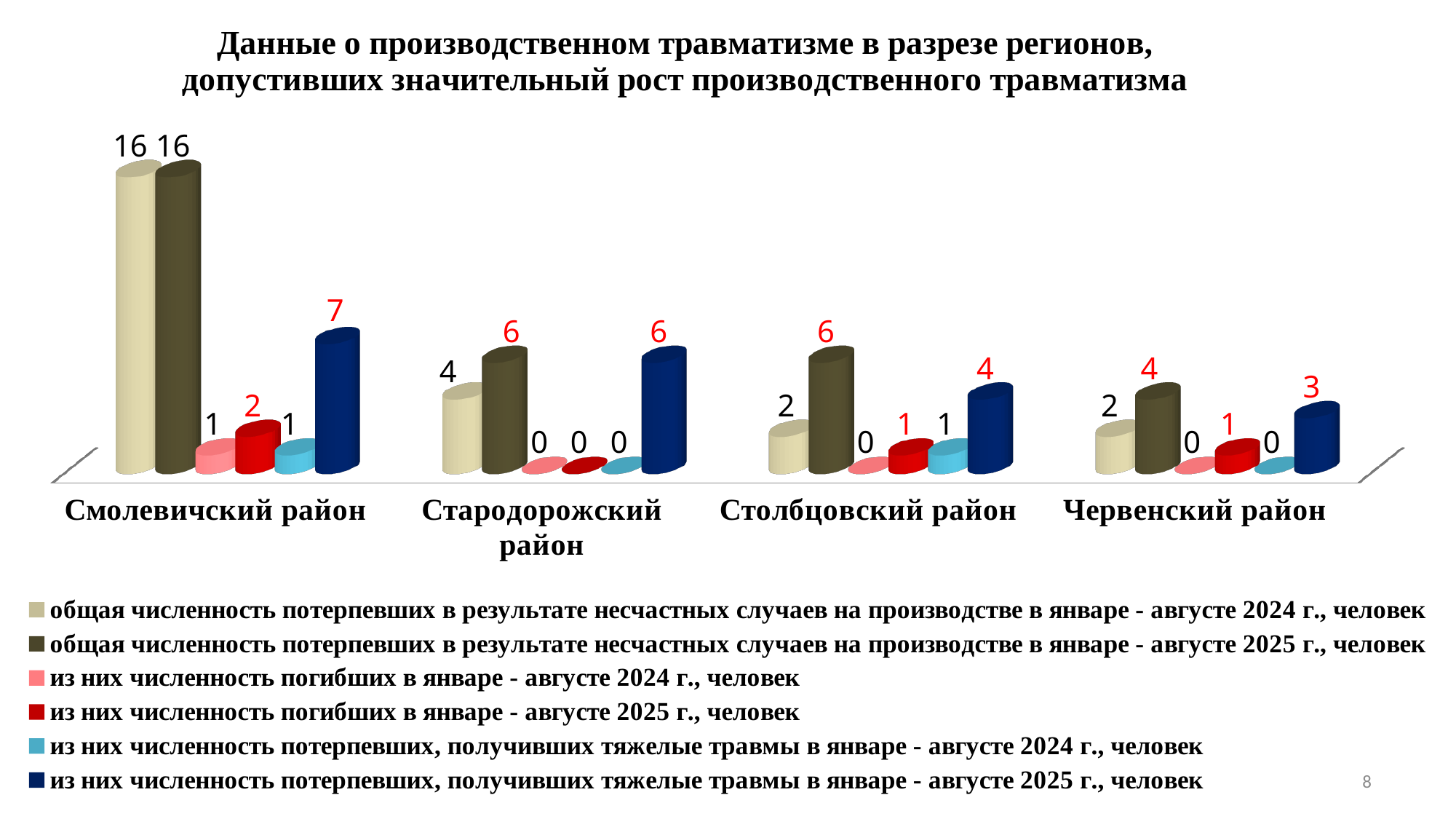
How many regions are shown on the chart? 4 What colour are the bars for the number of persons who died in January–August 2025? Red Which is larger for Смолевичский район: the number of persons with severe injuries in January–August 2025 or in January–August 2024? January–August 2025 Which region has the highest total number of injured persons in January–August 2025? Смолевичский район How many persons died in January–August 2025 in Червенский район? 1 What is the total number of injured persons in January–August 2025 for Смолевичский район? 16 Which region has the lowest number of persons with severe injuries in January–August 2025? Червенский район What is the total number of injured persons in January–August 2024 for Стародорожский район? 4 How many persons received severe injuries in January–August 2025 in Столбцовский район? 4 How many series does the legend list? 6 What is the difference between the total number of injured persons in January–August 2025 and January–August 2024 for Столбцовский район? 4 What kind of chart is shown on the slide? Bar chart